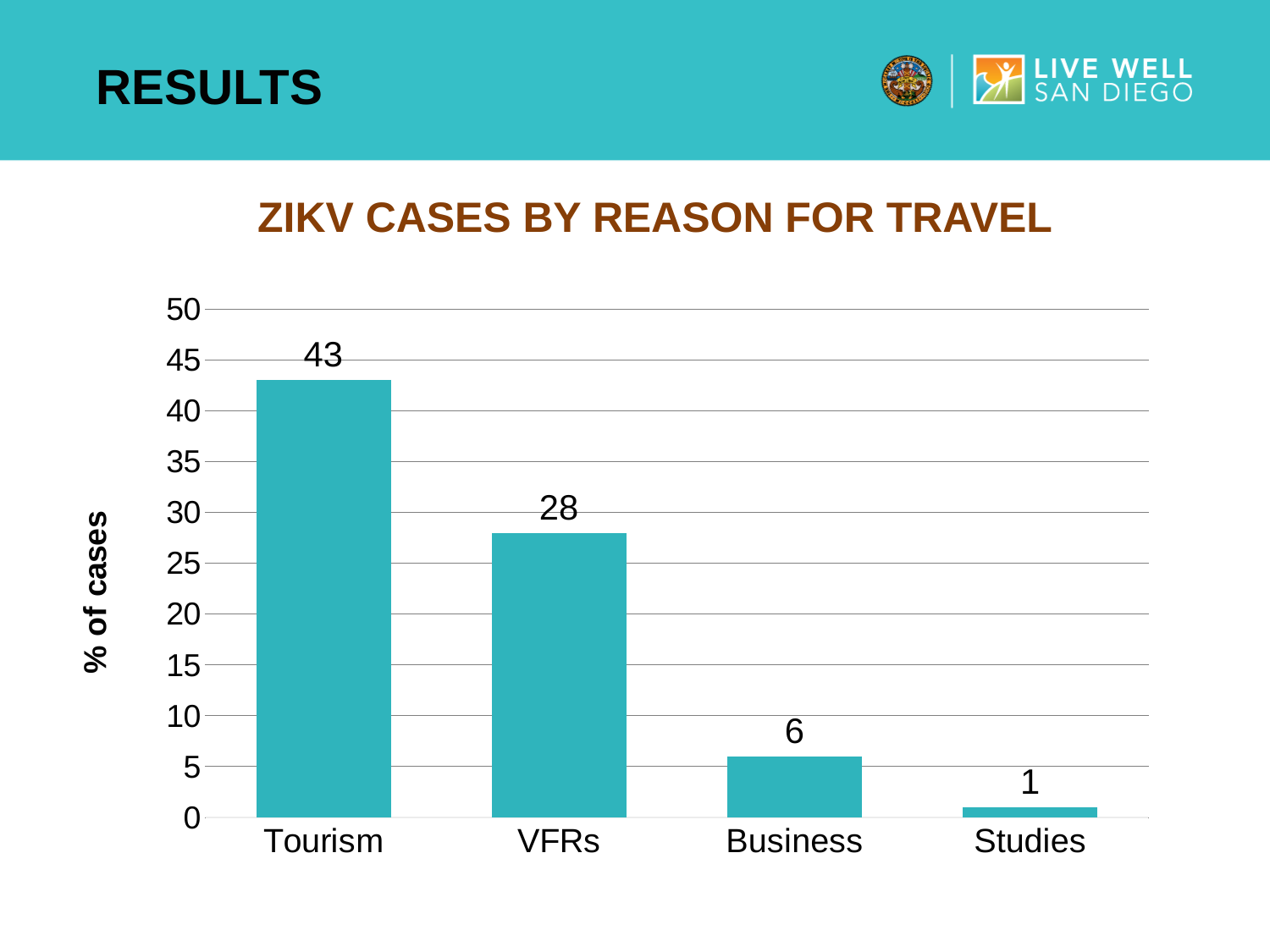
What is the value for Tourism? 43 What is the value for Studies? 1 How many categories are shown on the x axis? 4 What is the label of the y axis? % of cases What is the value for Business? 6 Is the value for VFRs greater or less than 30? less Which is larger, the value for Business or the value for Studies? Business What is the value for VFRs? 28 What is the difference between the values for Tourism and VFRs? 15 Which reason for travel has the lowest percentage of cases? Studies What kind of chart is shown on the slide? Bar chart Which reason for travel has the highest percentage of cases? Tourism